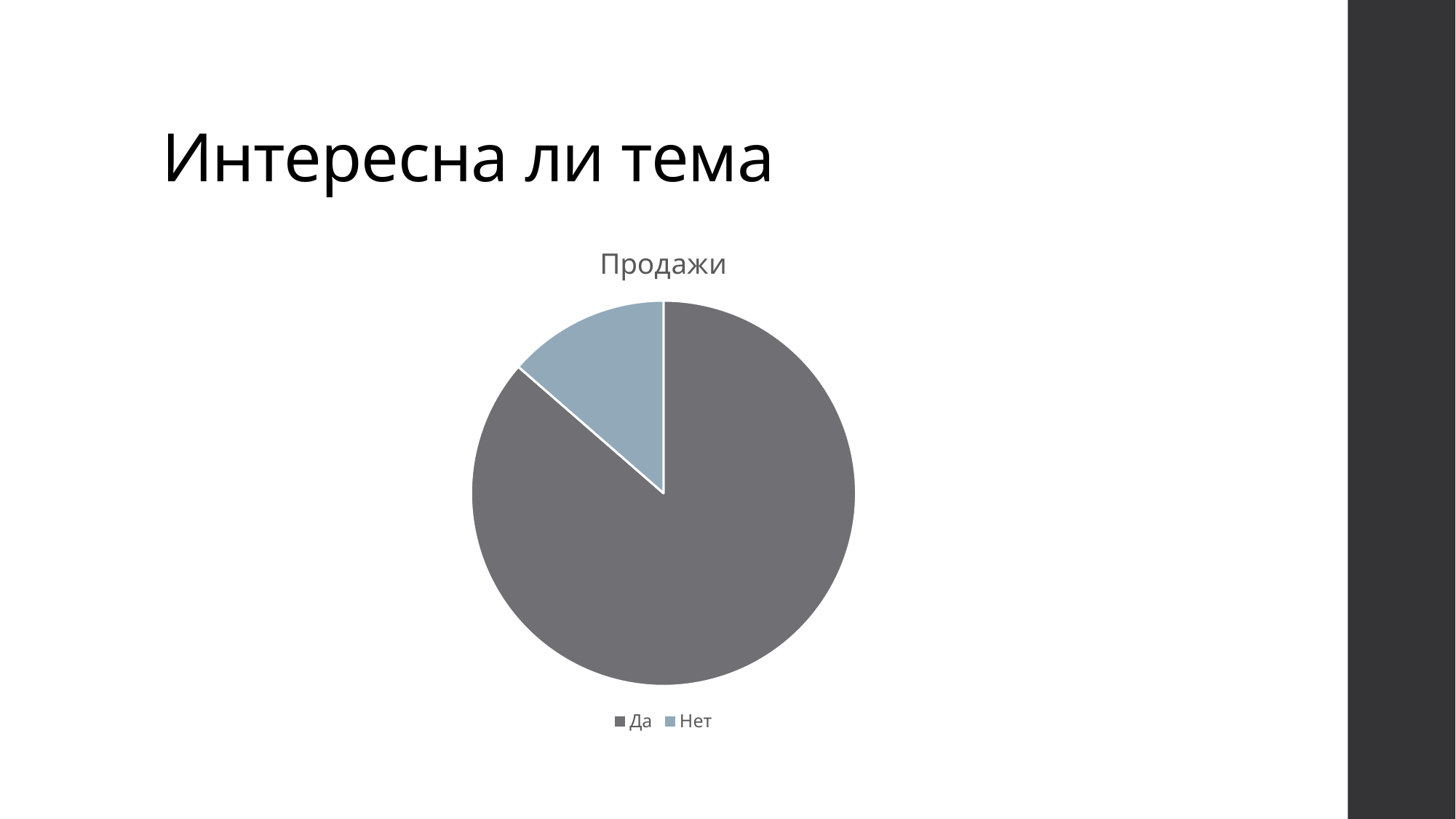
What is the title of the chart? Продажи How many categories does the pie chart have? 2 Which slice is larger, Да or Нет? Да What kind of chart is shown on the slide? pie chart Which category has the largest slice of the pie? Да Which category has the smallest slice of the pie? Нет What are the legend entries of the chart? Да, Нет